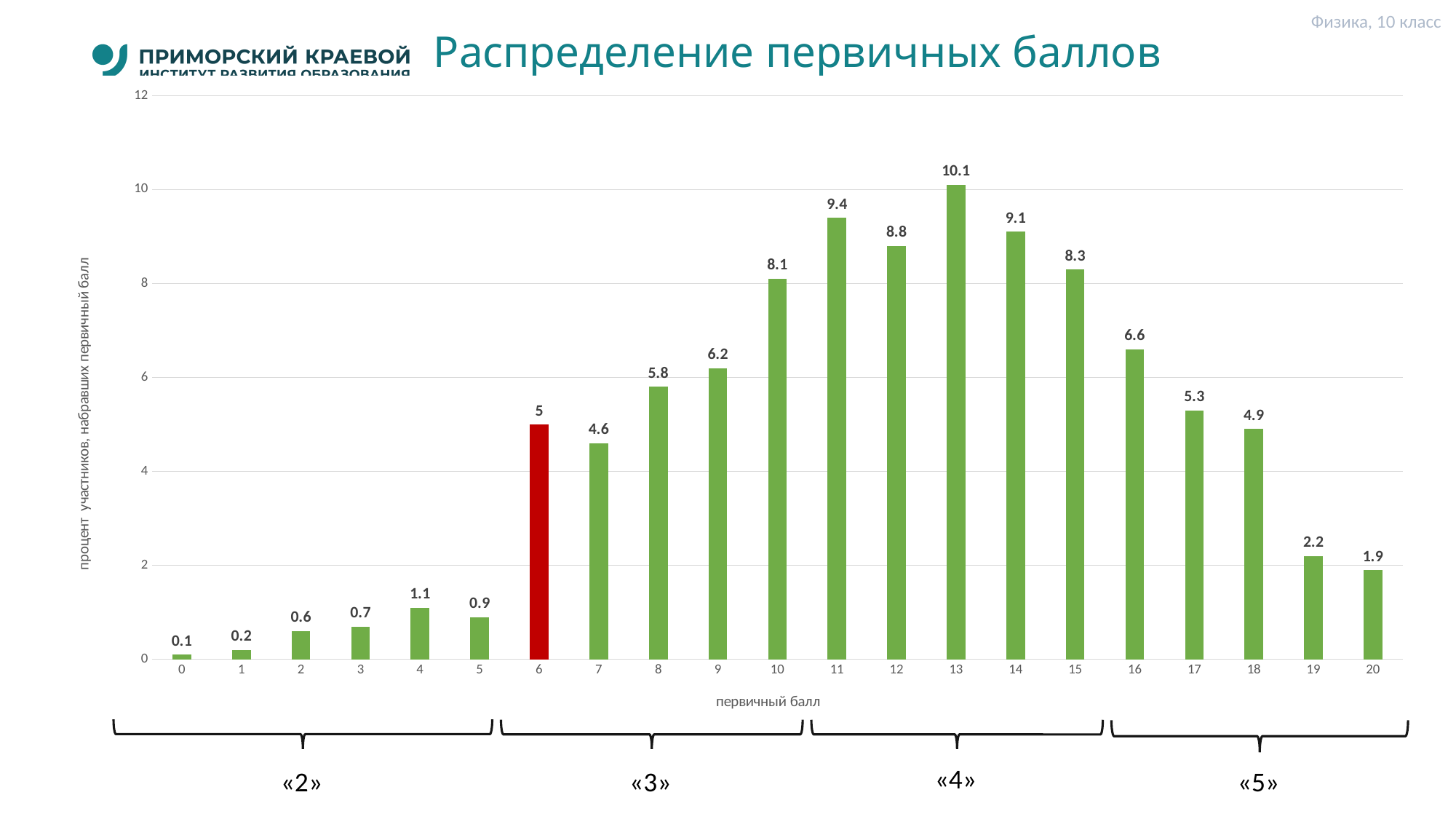
Is the value for primary score 10 greater or less than 8? greater What is the difference between the values for primary scores 13 and 11? 0.7 What is the value for primary score 6? 5 How many primary score categories are shown on the x axis? 21 Which is larger, the value for primary score 12 or for primary score 14? 14 What type of chart is shown on the slide? bar chart Which primary score's bar is coloured red? 6 What is the percentage of participants who scored 13 primary points? 10.1 Which primary score has the highest percentage of participants? 13 What is the value for primary score 20? 1.9 Do the values rise or fall along the x axis from primary score 13 to 20? fall Which primary score has the lowest percentage of participants? 0